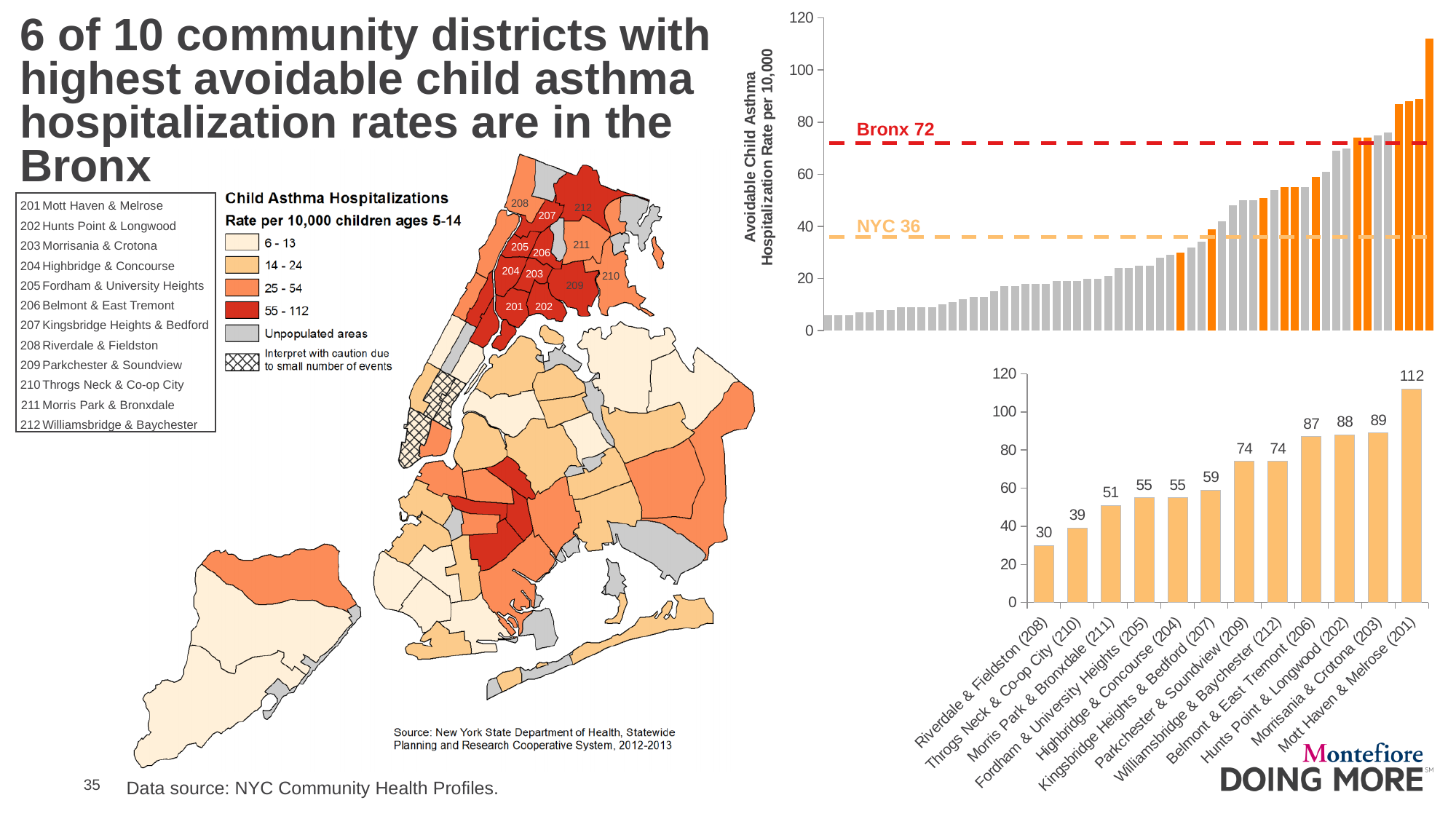
What kind of chart is the bottom-right chart? Bar chart In the top-right bar chart, what value is marked by the red dashed line labeled Bronx? 72 In the bottom-right bar chart, what is the value for Kingsbridge Heights & Bedford (207)? 59 In the bottom-right bar chart, what is the difference between the values for Mott Haven & Melrose (201) and Morrisania & Crotona (203)? 23 In the bottom-right bar chart, do the values rise or fall from left to right? Rise In the bottom-right bar chart, which is larger: the value for Throgs Neck & Co-op City (210) or Morris Park & Bronxdale (211)? Morris Park & Bronxdale (211) In the bottom-right bar chart, which community district has the lowest rate? Riverdale & Fieldston (208) In the top-right bar chart, what value is marked by the dashed line labeled NYC? 36 In the bottom-right bar chart, what is the value for Riverdale & Fieldston (208)? 30 In the bottom-right bar chart, which community district has the highest rate? Mott Haven & Melrose (201) How many community districts are shown in the bottom-right bar chart? 12 In the bottom-right bar chart, what is the avoidable child asthma hospitalization rate for Mott Haven & Melrose (201)? 112